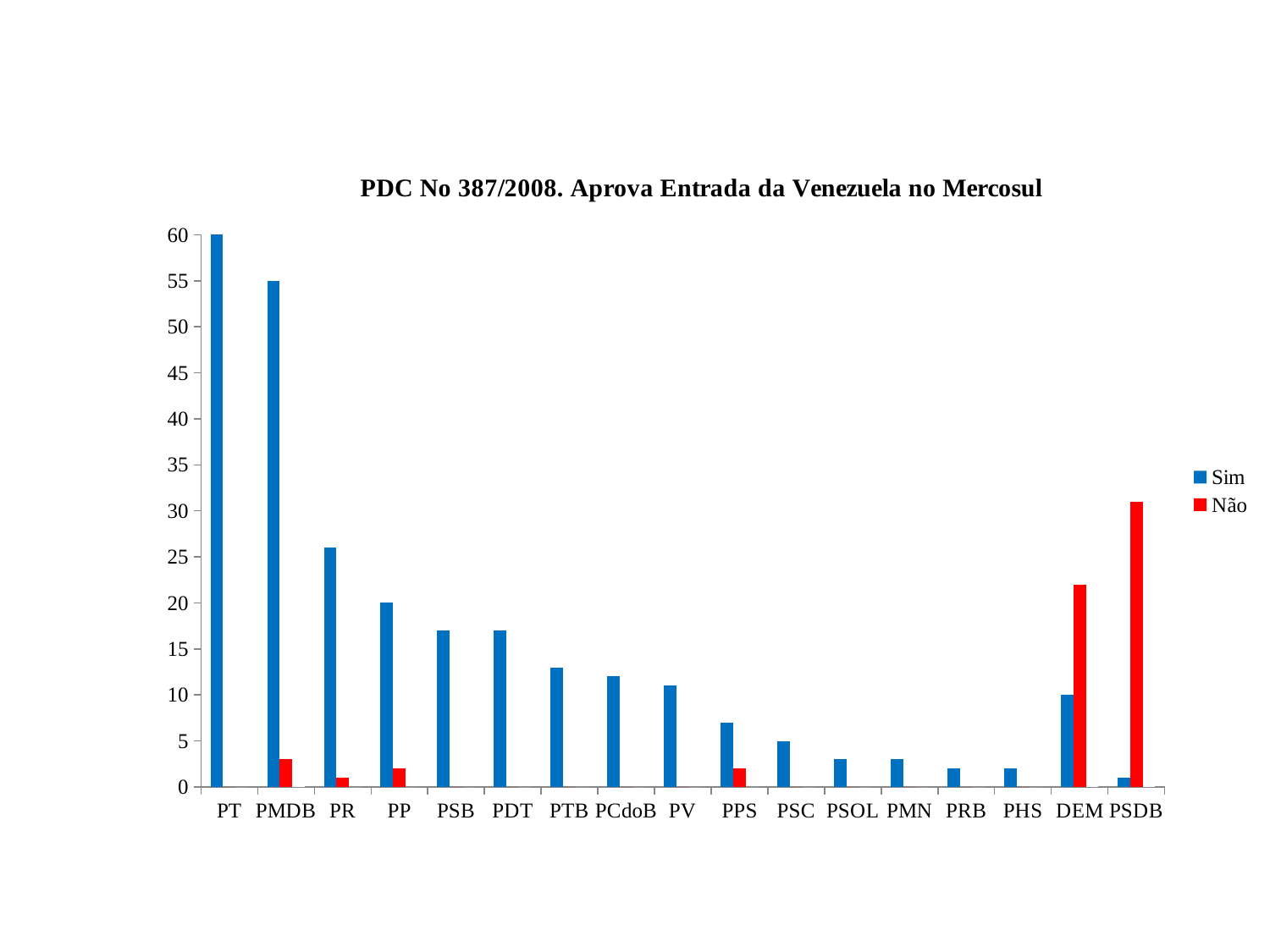
How many series does the legend list? 2 What is the Sim value for PMDB? 55 Which is larger, the Sim value for PR or the Sim value for PP? PR What is the Sim value for PP? 20 Which party has the highest Não value? PSDB What is the Sim value for PT? 60 What is the difference between the Sim values for PT and PMDB? 5 What kind of chart is shown on the slide? bar chart What is the title of the chart? PDC No 387/2008. Aprova Entrada da Venezuela no Mercosul Which party has the highest Sim value? PT How many parties are shown along the x axis? 17